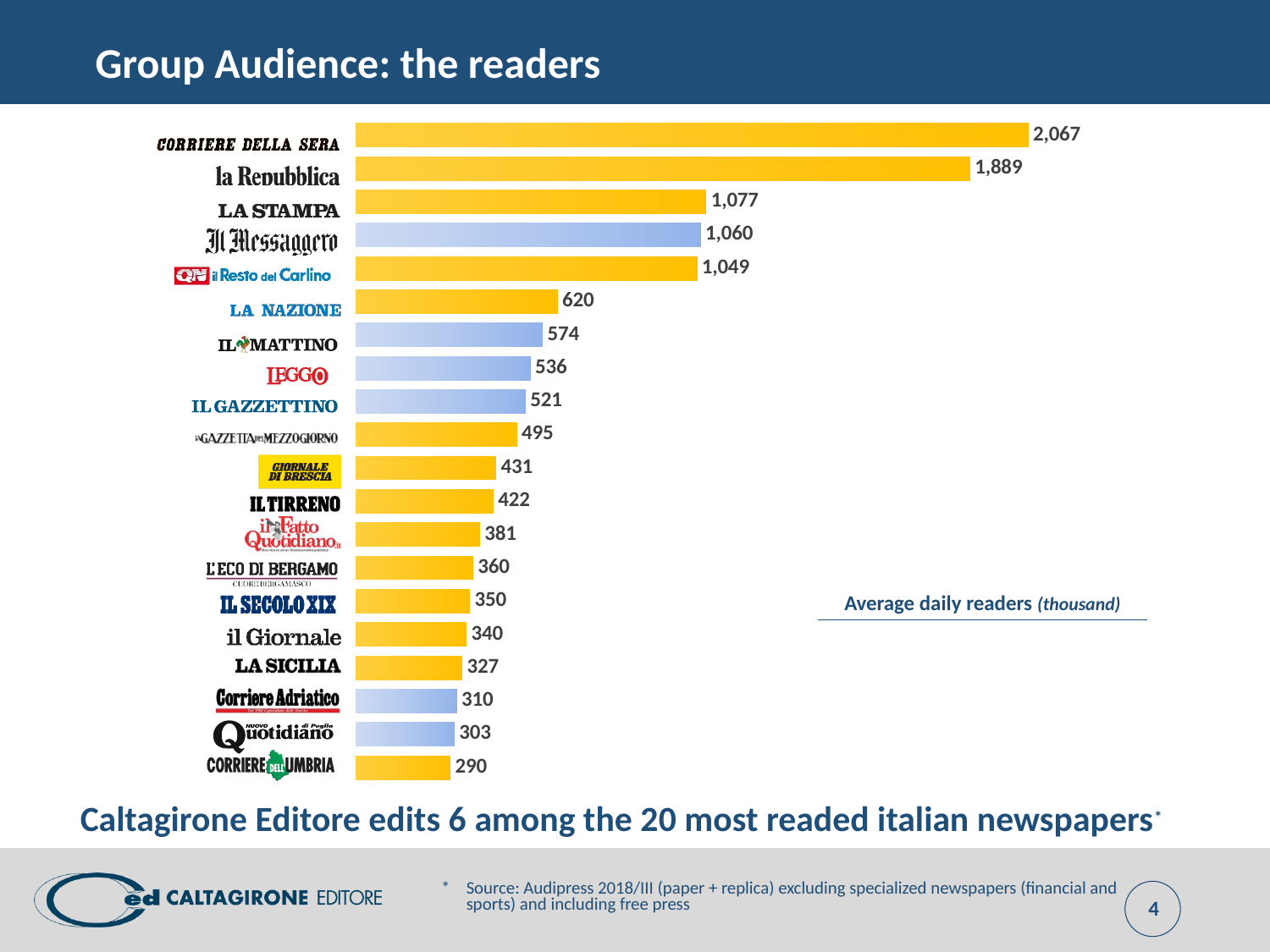
What is the average daily readers value for Il Messaggero? 1,060 In what unit are the average daily readers expressed in the chart? Thousand What is the average daily readers value for Leggo? 536 What is the difference in average daily readers between Corriere della Sera and la Repubblica? 178 How many newspapers are shown in the chart? 20 Which has more average daily readers, Il Tirreno or Il Secolo XIX? Il Tirreno What type of chart is shown on the slide? Bar chart Which newspaper has the lowest average daily readers? Corriere dell'Umbria What is the average daily readers value for Corriere della Sera? 2,067 Which has more average daily readers, La Stampa or Il Messaggero? La Stampa Which newspaper has the highest average daily readers? Corriere della Sera What is the difference in average daily readers between Il Mattino and Il Gazzettino? 53